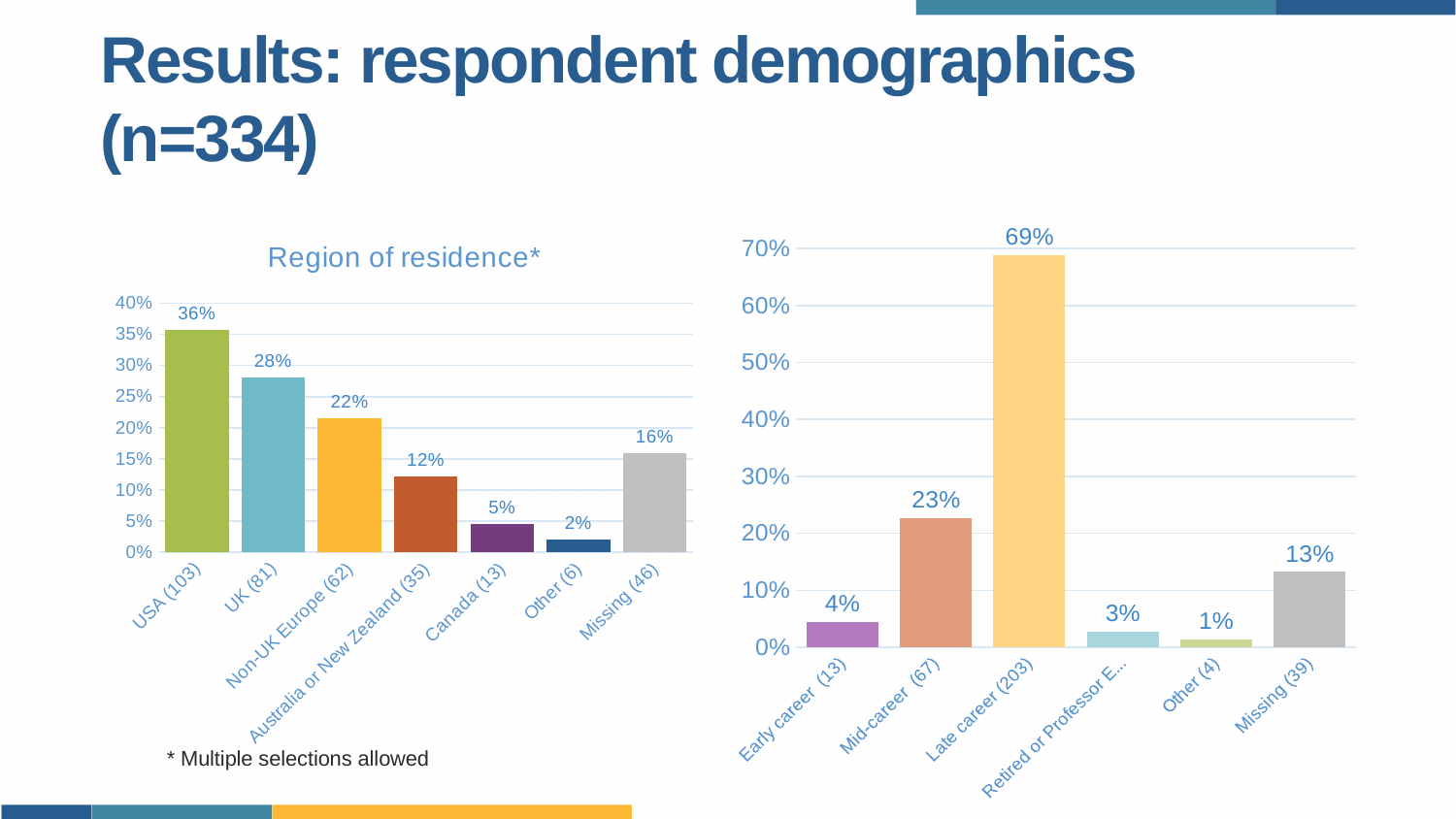
In the "Region of residence*" chart, what is the value for Australia or New Zealand (35)? 12% In the "Region of residence*" chart, what is the value for USA (103)? 36% In the "Region of residence*" chart, how many categories are shown? 7 In the "Region of residence*" chart, which is larger, the value for Missing (46) or the value for Canada (13)? Missing (46) In the chart on the right, what is the difference between the values for Late career (203) and Missing (39)? 56% In the "Region of residence*" chart, what is the difference between the values for UK (81) and Non-UK Europe (62)? 6% In the "Region of residence*" chart, which category has the lowest value? Other (6) In the chart on the right, which category has the highest value? Late career (203) What kind of chart is the "Region of residence*" chart? Bar chart In the chart on the right, how many categories are shown? 6 In the chart on the right, what is the value for Late career (203)? 69% In the chart on the right, what is the value for Mid-career (67)? 23%